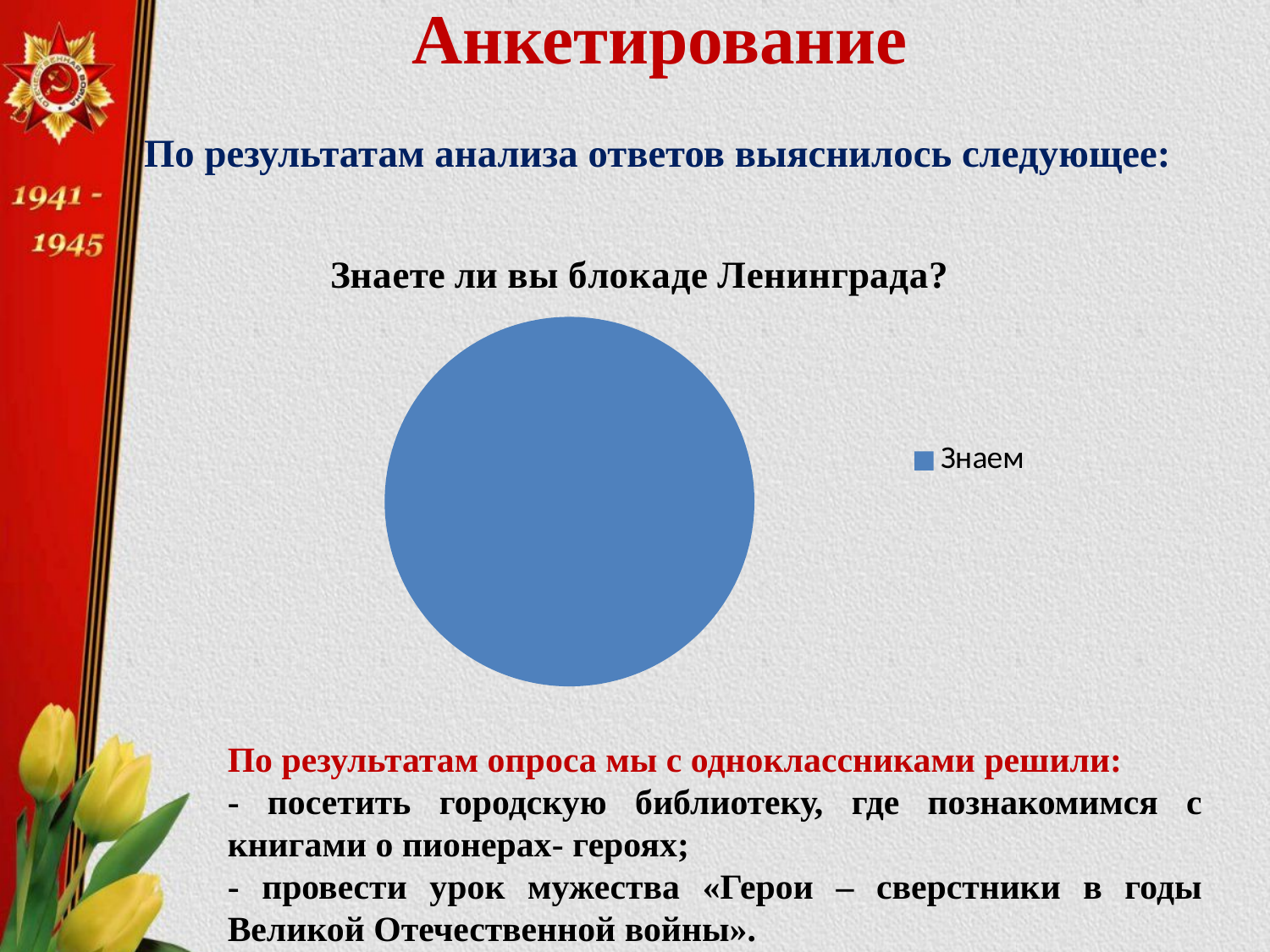
What is the label of the only legend entry in the pie chart? Знаем How many slices does the pie chart have? 1 What share of the pie does the "Знаем" slice take up? 100% What is the title of the pie chart? Знаете ли вы блокаде Ленинграда? How many entries does the legend of the pie chart list? 1 What kind of chart is shown on the slide? pie chart